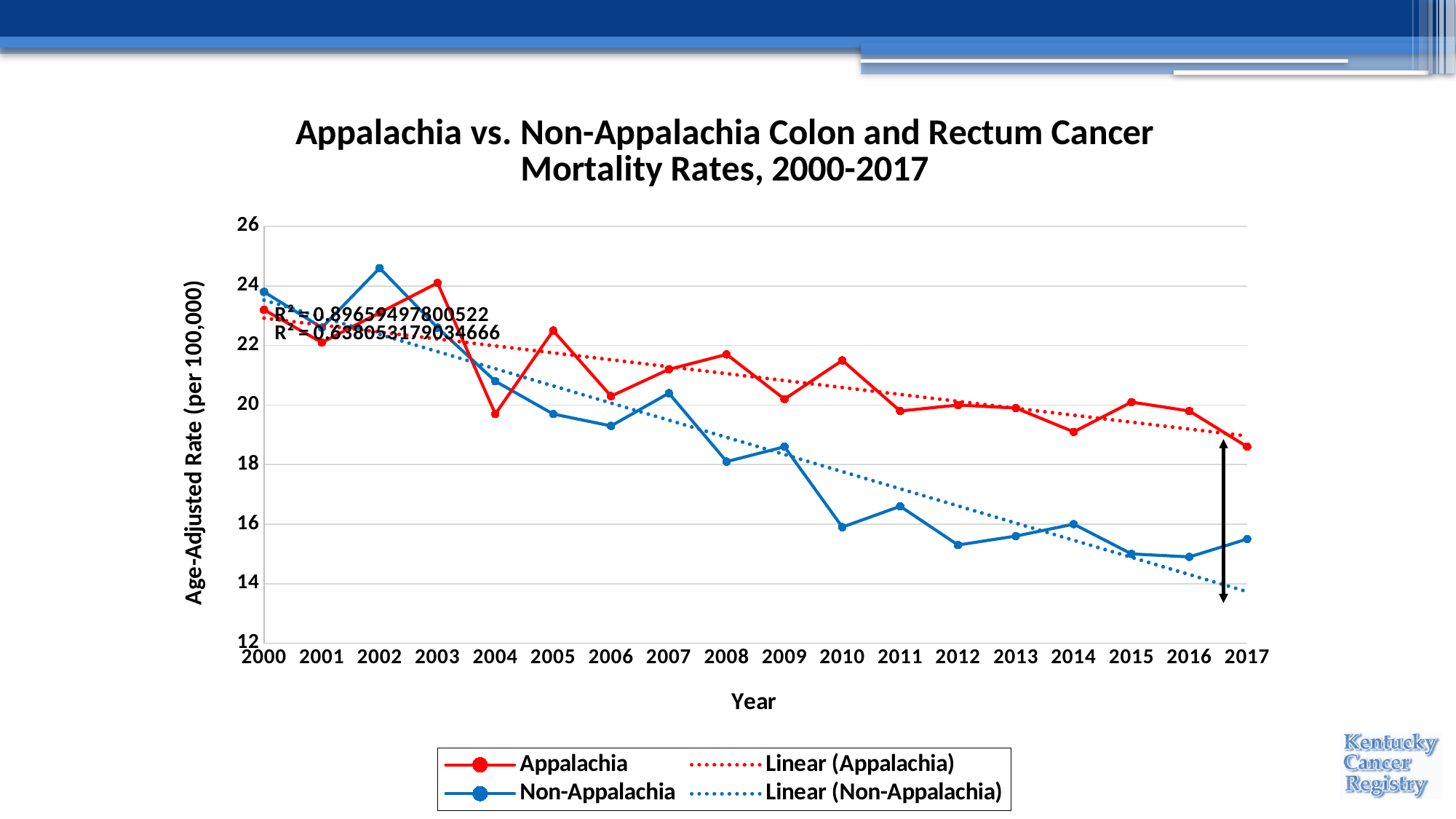
How many entries does the legend list? 4 What is the title of the chart? Appalachia vs. Non-Appalachia Colon and Rectum Cancer Mortality Rates, 2000-2017 What kind of chart is shown on the slide? Line chart How many years are plotted along the x axis? 18 Overall, do the Non-Appalachia mortality rates rise or fall from 2000 to 2017? Fall In 2017, which series has the higher mortality rate, Appalachia or Non-Appalachia? Appalachia Is the Non-Appalachia value for 2000 greater or less than 22? greater Is the Appalachia value for 2010 greater or less than 20? greater Is the Non-Appalachia value for 2008 greater or less than 20? less In which year does the Non-Appalachia series reach its highest value? 2002 In which year does the Appalachia series reach its highest value? 2003